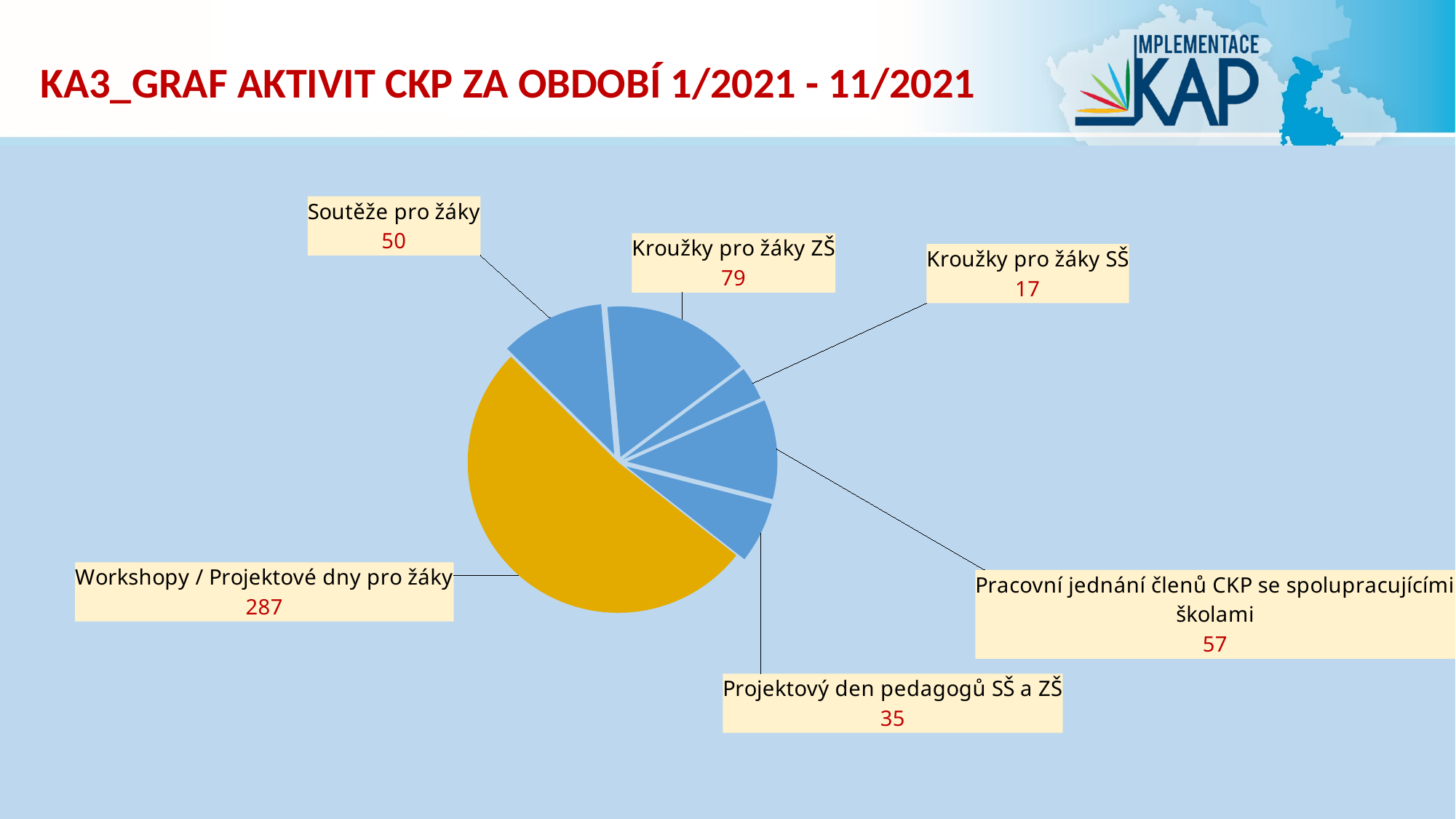
What is the value for Workshopy / Projektové dny pro žáky? 287 What is the difference between Soutěže pro žáky and Projektový den pedagogů SŠ a ZŠ? 15 Which category has the smallest slice of the pie? Kroužky pro žáky SŠ What is the difference between Kroužky pro žáky ZŠ and Kroužky pro žáky SŠ? 62 What kind of chart is shown on the slide? pie chart What is the value for Projektový den pedagogů SŠ a ZŠ? 35 How many slices does the pie chart have? 6 Which category has the largest slice of the pie? Workshopy / Projektové dny pro žáky Which is larger, Soutěže pro žáky or Pracovní jednání členů CKP se spolupracujícími školami? Pracovní jednání členů CKP se spolupracujícími školami What is the title of the slide containing the chart? KA3_GRAF AKTIVIT CKP ZA OBDOBÍ 1/2021 - 11/2021 What is the value for Kroužky pro žáky ZŠ? 79 What is the value for Pracovní jednání členů CKP se spolupracujícími školami? 57